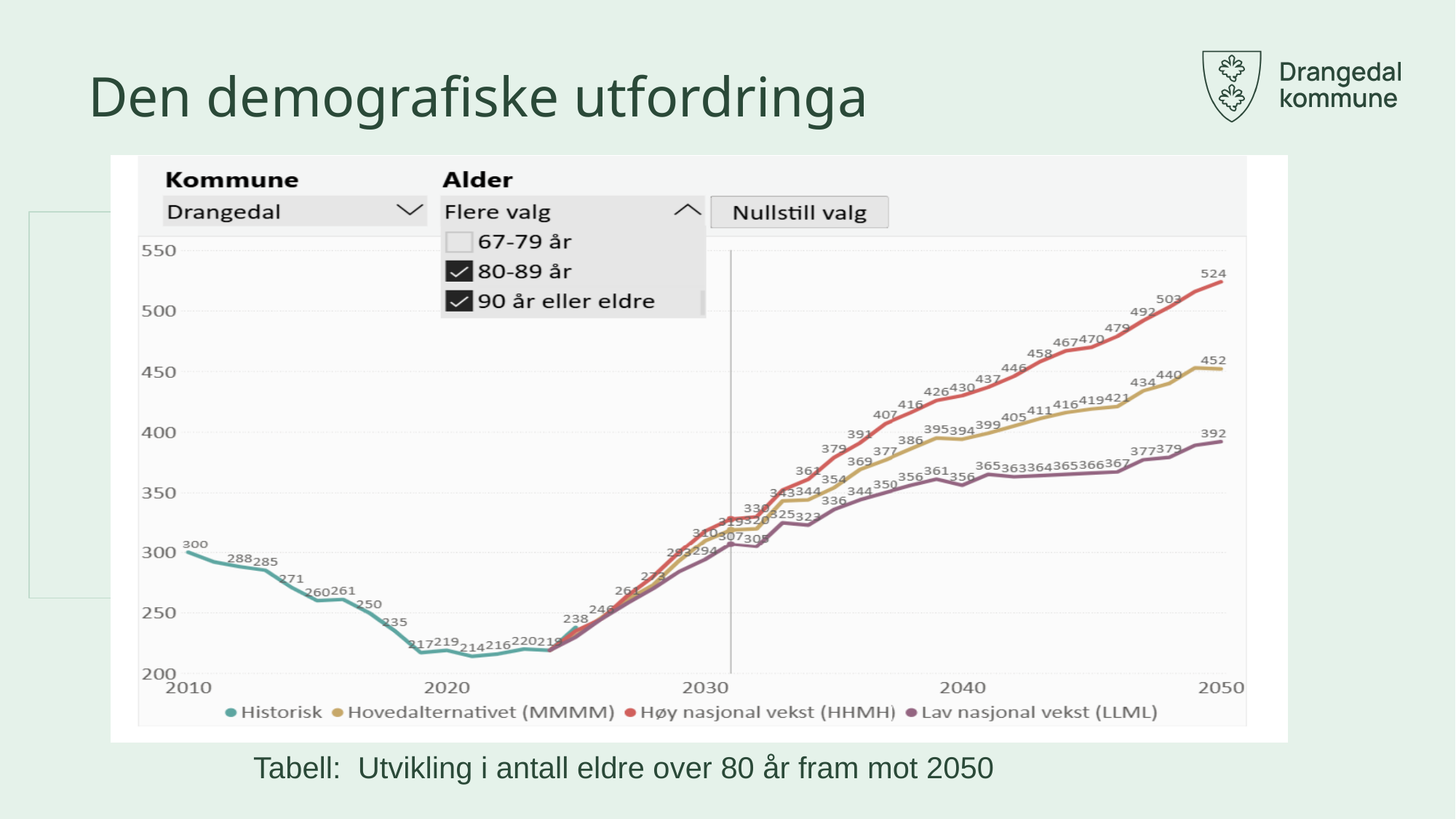
Which series has the lowest value in 2050? Lav nasjonal vekst (LLML) What is the value of the Hovedalternativet (MMMM) series in 2050? 452 What kind of chart is shown on the slide? line chart Does the Historisk series rise or fall between 2010 and 2020? fall What is the value of the Høy nasjonal vekst (HHMH) series in 2050? 524 How many series does the legend list? 4 What is the value of the Lav nasjonal vekst (LLML) series in 2050? 392 What is the caption text below the chart? Tabell: Utvikling i antall eldre over 80 år fram mot 2050 Is the value of the Lav nasjonal vekst (LLML) series in 2040 greater or less than 400? less Which series has the highest value in 2050? Høy nasjonal vekst (HHMH) What is the difference between the Høy nasjonal vekst (HHMH) and Lav nasjonal vekst (LLML) values in 2050? 132 What is the value of the Historisk series in 2010? 300